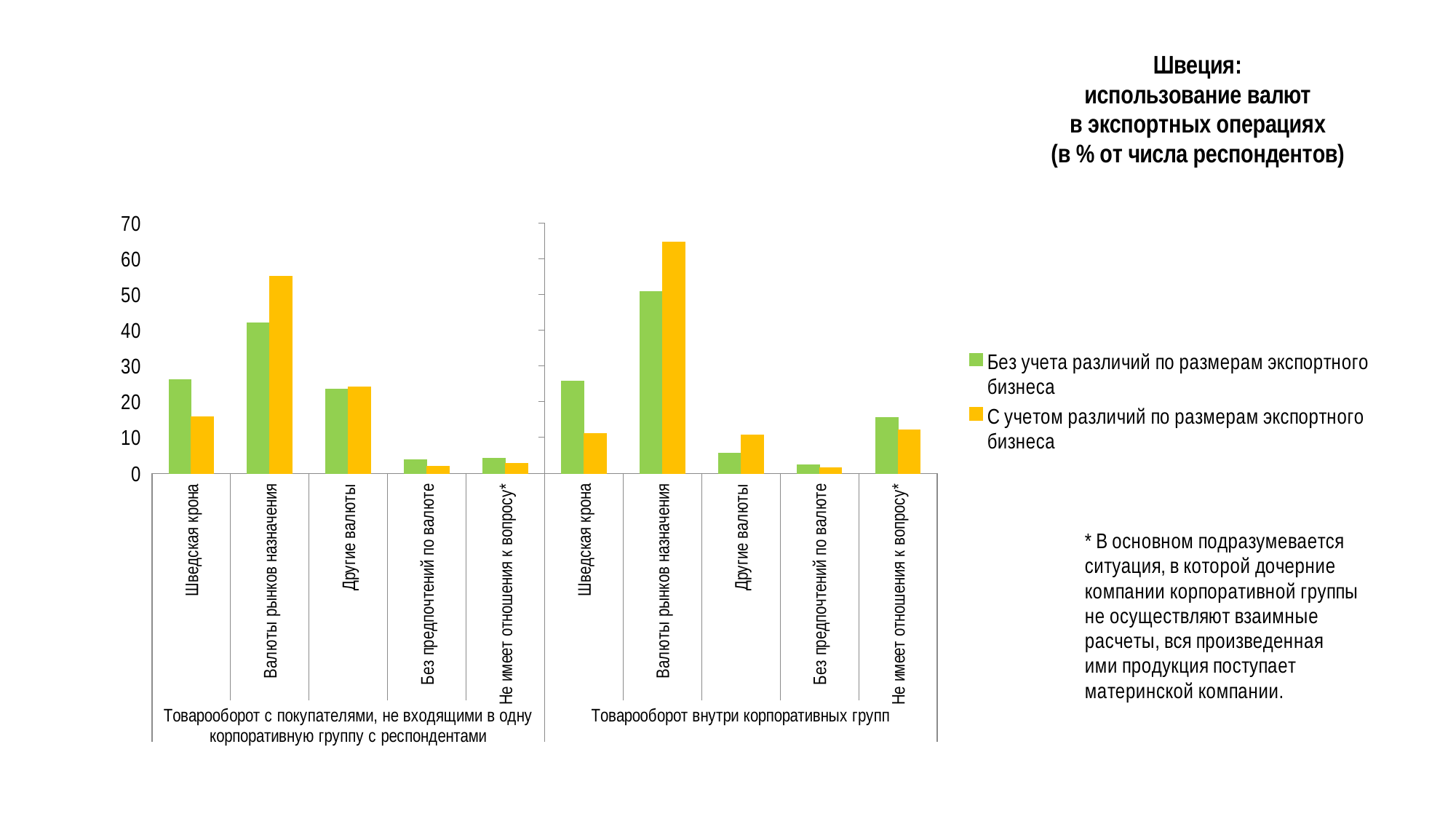
What colour represents the series "С учетом различий по размерам экспортного бизнеса"? Yellow In the group "Товарооборот с покупателями, не входящими в одну корпоративную группу с респондентами", is the value of "Без учета различий по размерам экспортного бизнеса" for "Валюты рынков назначения" greater or less than 50? less How many categories are plotted in the group "Товарооборот внутри корпоративных групп"? 5 How many categories are plotted in total across both groups of the chart? 10 For "Шведская крона" in the group "Товарооборот внутри корпоративных групп", which series has the larger value? Без учета различий по размерам экспортного бизнеса In the group "Товарооборот с покупателями, не входящими в одну корпоративную группу с респондентами", is the value of "Без учета различий по размерам экспортного бизнеса" for "Шведская крона" greater or less than 30? less How many series does the legend list? 2 Which category has the tallest bar in the whole chart? Валюты рынков назначения (Товарооборот внутри корпоративных групп) Which category has the lowest bars in the group "Товарооборот внутри корпоративных групп"? Без предпочтений по валюте What kind of chart is shown on the slide? Bar chart In the group "Товарооборот внутри корпоративных групп", is the value of "С учетом различий по размерам экспортного бизнеса" for "Валюты рынков назначения" greater or less than 60? greater For "Валюты рынков назначения" in the group "Товарооборот с покупателями, не входящими в одну корпоративную группу с респондентами", which series has the larger value? С учетом различий по размерам экспортного бизнеса